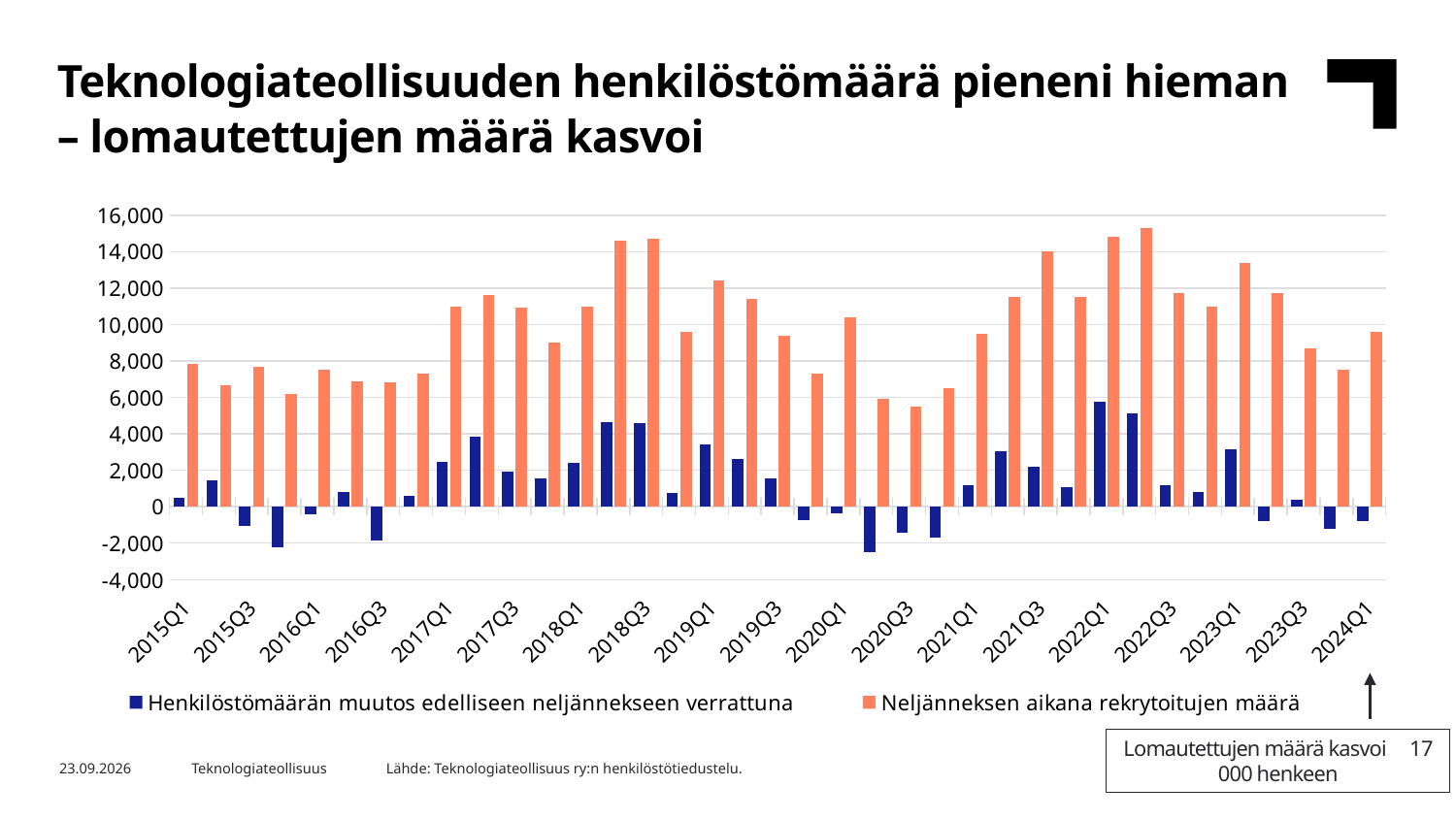
Is the value of Neljänneksen aikana rekrytoitujen määrä for 2020Q3 greater or less than 8,000? less How many quarter labels are shown on the x axis? 19 Is the value of Neljänneksen aikana rekrytoitujen määrä for 2024Q1 greater or less than 8,000? greater What kind of chart is shown on the slide? bar chart Which is larger for Henkilöstömäärän muutos edelliseen neljännekseen verrattuna: 2022Q1 or 2024Q1? 2022Q1 Which is larger for Neljänneksen aikana rekrytoitujen määrä: 2018Q3 or 2015Q1? 2018Q3 Is the value of Henkilöstömäärän muutos edelliseen neljännekseen verrattuna for 2022Q1 greater or less than 4,000? greater Does the Henkilöstömäärän muutos edelliseen neljännekseen verrattuna series generally rise or fall from 2022Q1 to 2024Q1? fall Which series is shown in orange according to the legend? Neljänneksen aikana rekrytoitujen määrä How many series does the legend list? 2